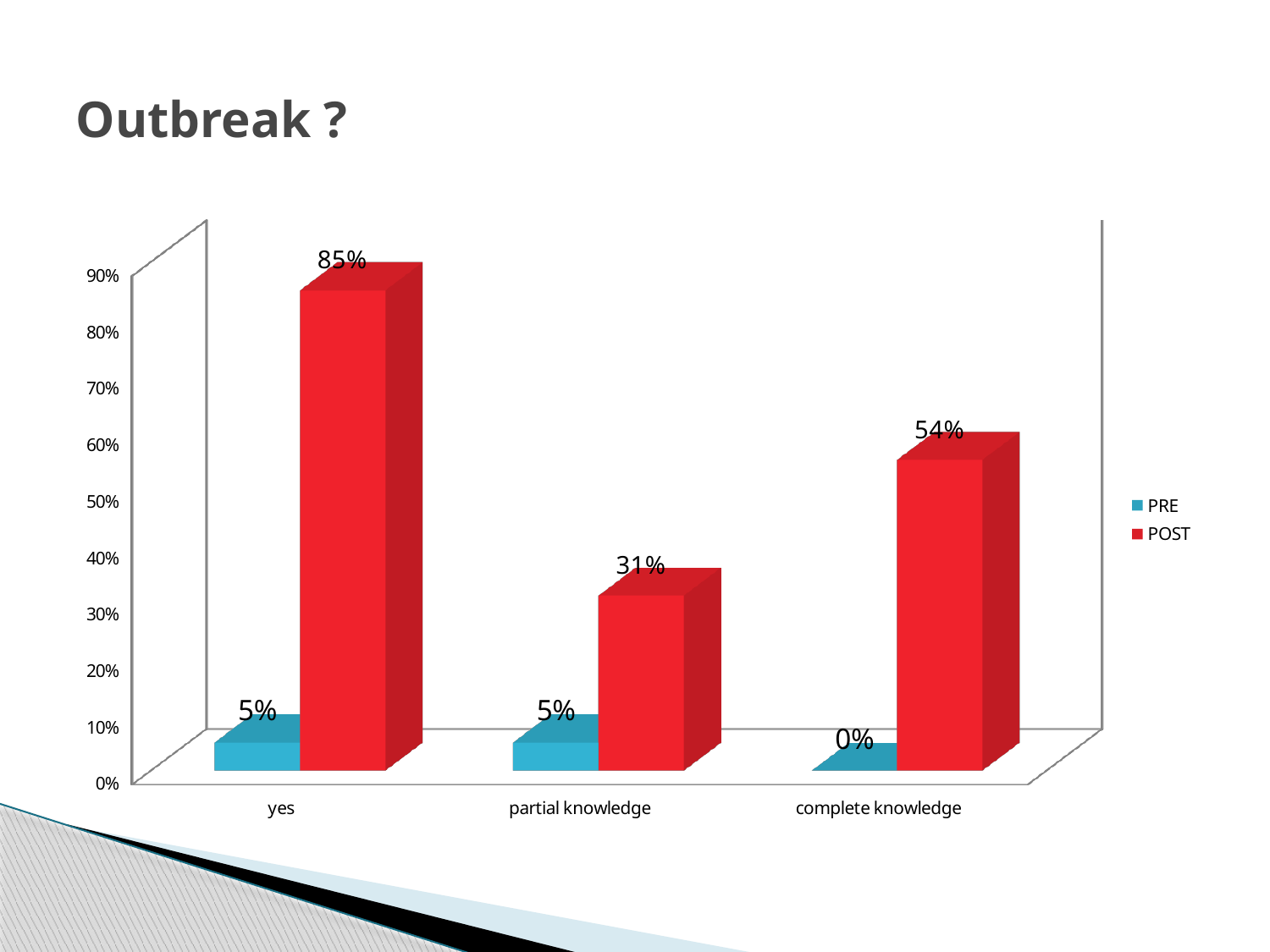
How many categories are shown on the x axis? 3 Which category has the highest POST value? yes How many series does the legend list? 2 What is the difference between the POST and PRE values for "yes"? 80% Which category has the lowest PRE value? complete knowledge What kind of chart is shown on the slide? bar chart What is the PRE value for "partial knowledge"? 5% What is the POST value for "partial knowledge"? 31% Which is larger: the POST value for "complete knowledge" or the POST value for "partial knowledge"? complete knowledge What is the POST value for "yes"? 85% What is the PRE value for "complete knowledge"? 0% What is the difference between the POST values for "complete knowledge" and "partial knowledge"? 23%